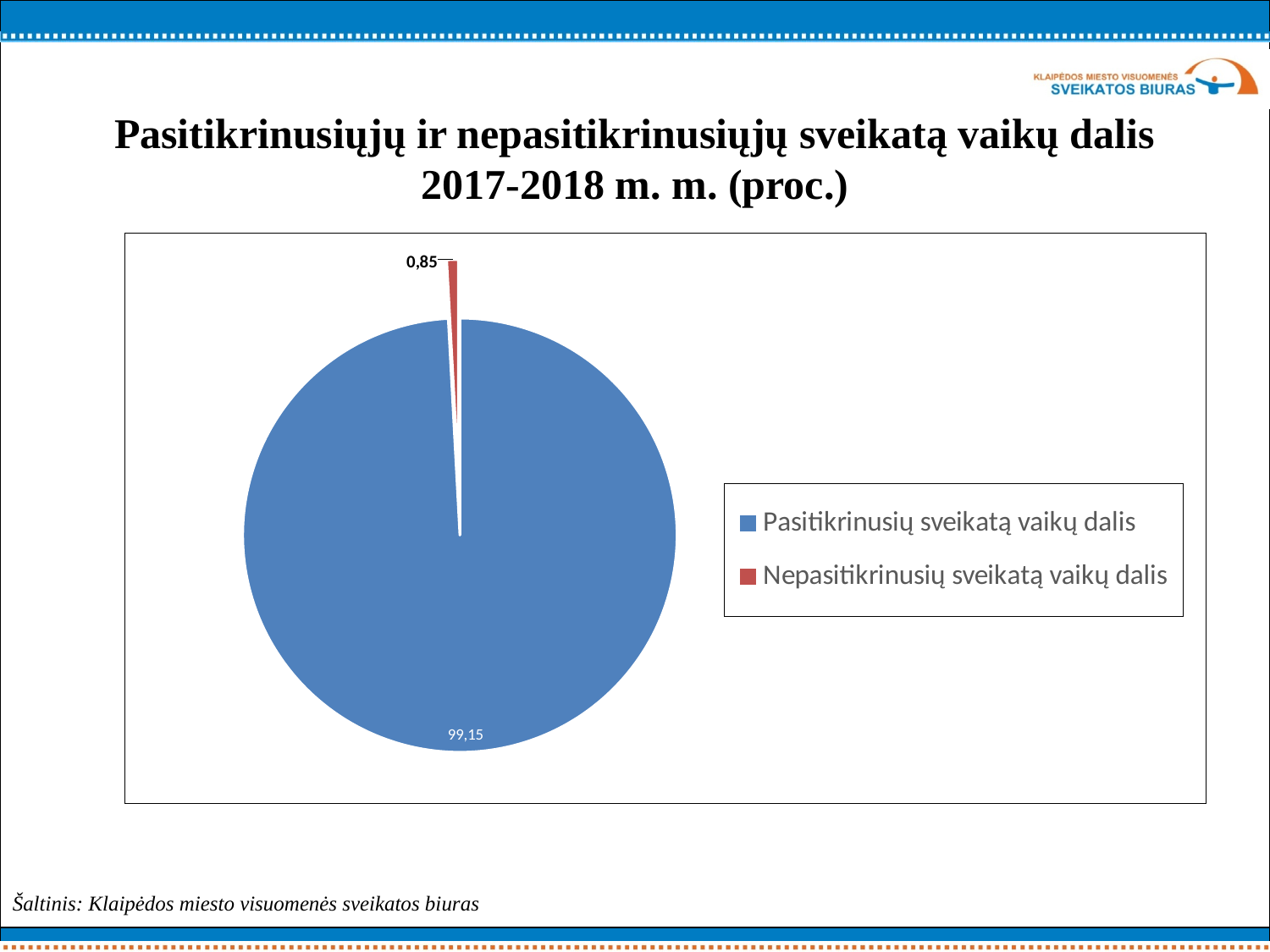
Which slice is the largest? Pasitikrinusių sveikatą vaikų dalis What is the value for Nepasitikrinusių sveikatą vaikų dalis? 0,85 What is the difference between the values for Pasitikrinusių sveikatą vaikų dalis and Nepasitikrinusių sveikatą vaikų dalis? 98,3 Which slice is the smallest? Nepasitikrinusių sveikatą vaikų dalis How many slices does the pie chart have? 2 What kind of chart is shown on the slide? pie chart What share of the pie does Nepasitikrinusių sveikatą vaikų dalis represent? 0,85% Which is larger: Pasitikrinusių sveikatą vaikų dalis or Nepasitikrinusių sveikatą vaikų dalis? Pasitikrinusių sveikatą vaikų dalis How many entries does the legend list? 2 What is the value for Pasitikrinusių sveikatą vaikų dalis? 99,15 What colour is the slice for Pasitikrinusių sveikatą vaikų dalis? blue What is the title of the chart on the slide? Pasitikrinusiųjų ir nepasitikrinusiųjų sveikatą vaikų dalis 2017-2018 m. m. (proc.)